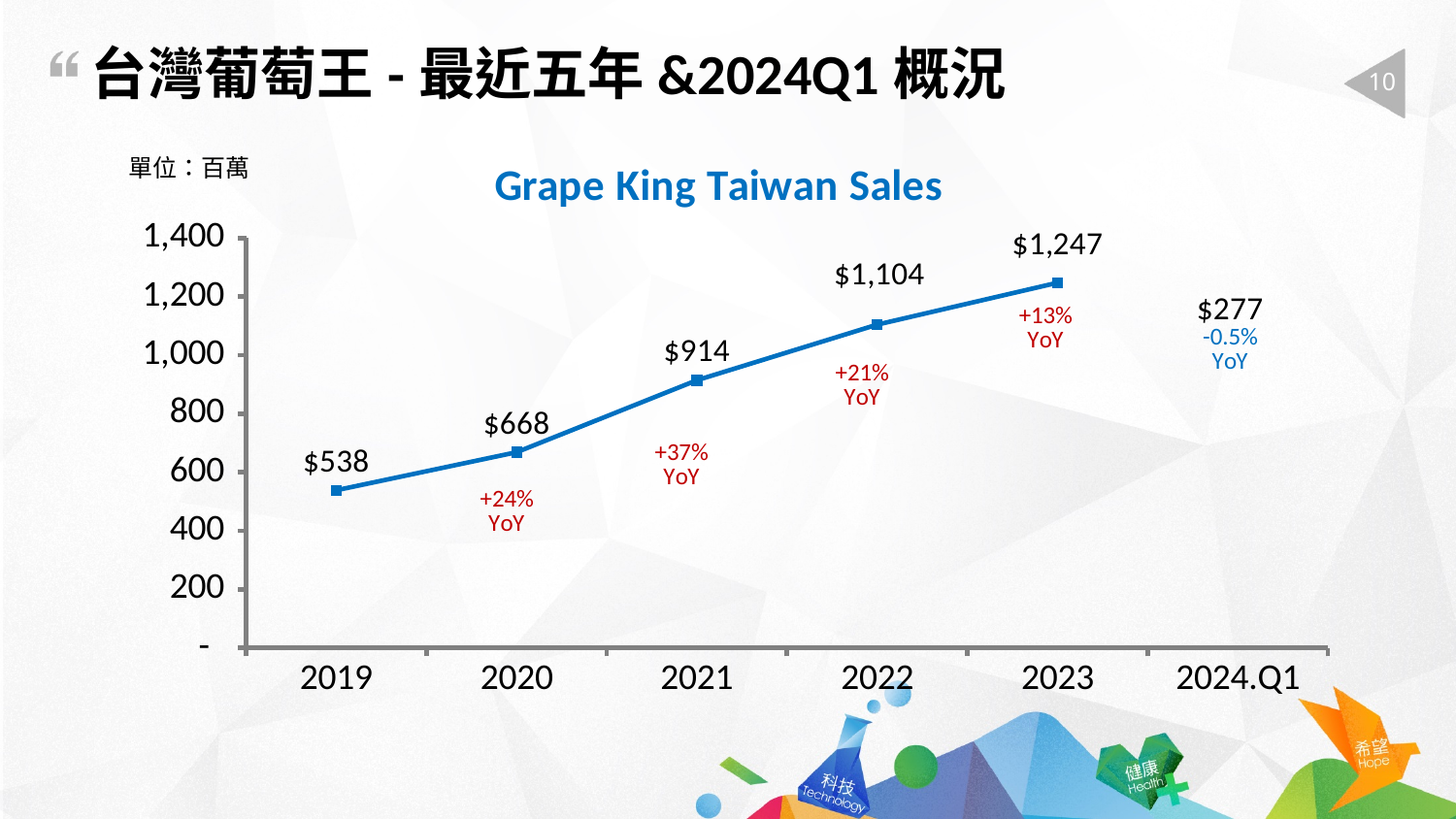
What is the Grape King Taiwan Sales value for 2021? $914 What is the sales value shown for 2024.Q1? $277 Which year from 2019 to 2023 has the highest sales value? 2023 What is the Grape King Taiwan Sales value for 2019? $538 Do the sales values rise or fall from 2019 to 2023? Rise What YoY growth rate is shown for 2021? +37% What is the Grape King Taiwan Sales value for 2023? $1,247 What is the title of the chart? Grape King Taiwan Sales Is the sales value for 2022 greater or less than 1,000? greater What type of chart is shown on the slide? Line chart Which year from 2019 to 2023 has the lowest sales value? 2019 What is the difference between the 2023 and 2022 sales values? $143